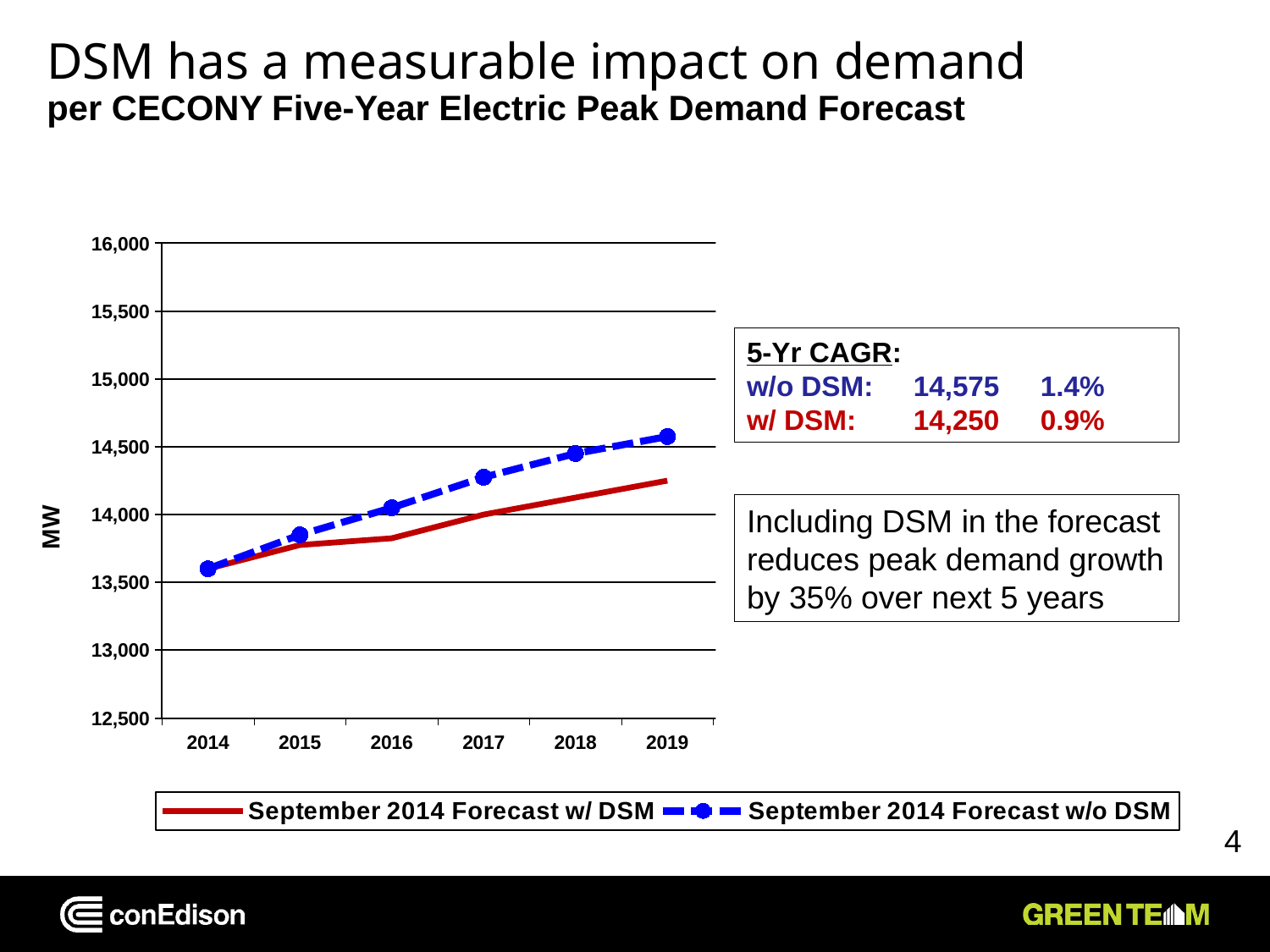
In which year is the September 2014 Forecast w/o DSM series at its highest? 2019 What is the label on the y axis of the chart? MW How many series does the chart legend list? 2 Is the 2019 value for the September 2014 Forecast w/o DSM series greater or less than 14,500? greater In 2018, which series has the larger value: September 2014 Forecast w/ DSM or September 2014 Forecast w/o DSM? September 2014 Forecast w/o DSM According to the text box on the slide, what is the 5-year CAGR with DSM? 0.9% In which year is the September 2014 Forecast w/ DSM series at its lowest? 2014 Do the values for the September 2014 Forecast w/o DSM series rise or fall from 2014 to 2019? rise Is the 2017 value for the September 2014 Forecast w/o DSM series greater or less than 14,000? greater Is the 2016 value for the September 2014 Forecast w/ DSM series greater or less than 14,000? less How many years are plotted along the x axis of the chart? 6 What kind of chart is shown on the slide? line chart